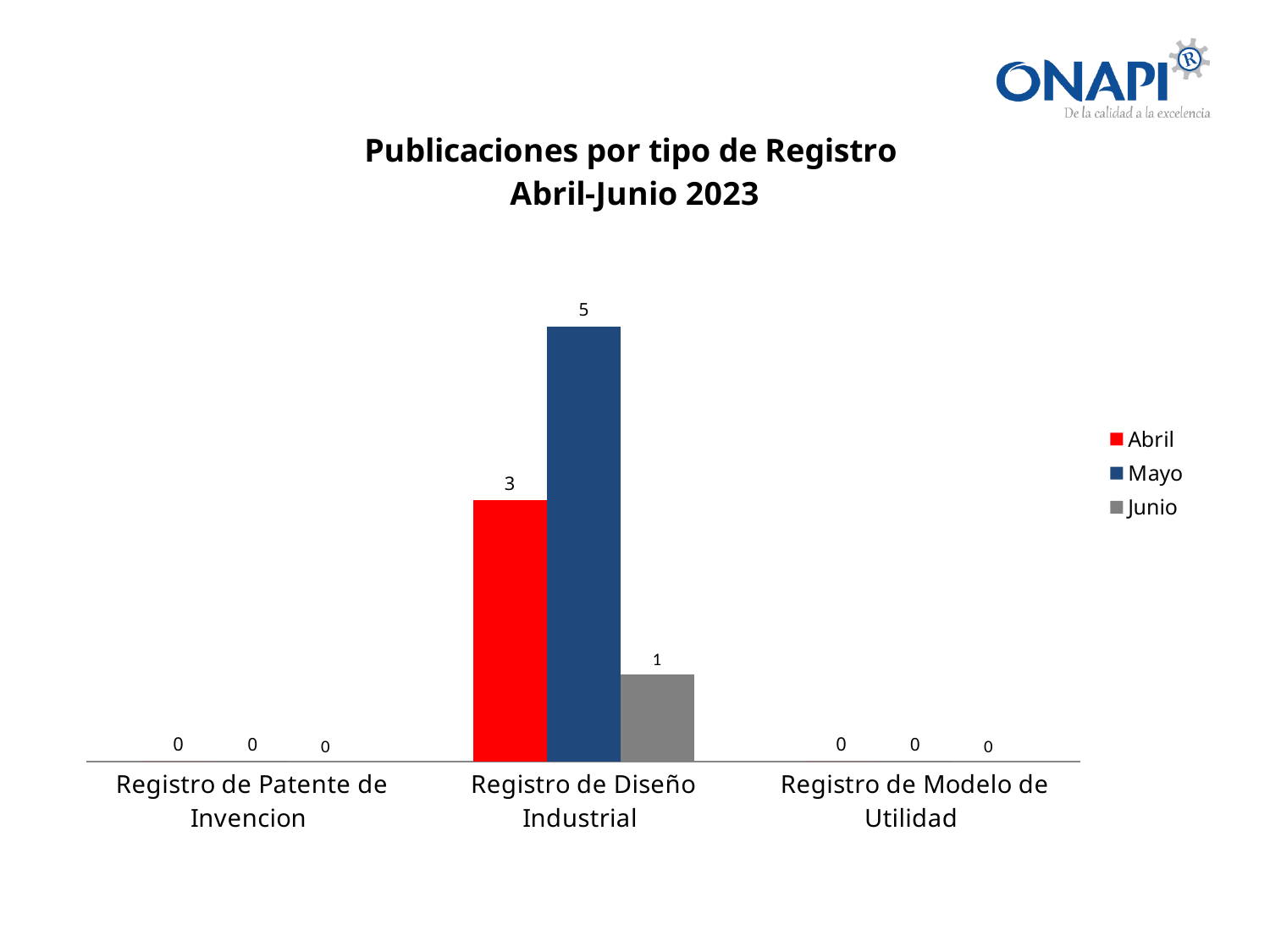
How many series does the legend list? 3 Which is larger for Registro de Diseño Industrial, the Abril value or the Junio value? Abril Which month has the highest value in the Registro de Diseño Industrial category? Mayo How many categories are shown on the x axis? 3 What is the value for Mayo in the Registro de Patente de Invencion category? 0 What is the difference between the Mayo and Abril values for Registro de Diseño Industrial? 2 What kind of chart is shown on the slide? Bar chart What is the value for Mayo in the Registro de Diseño Industrial category? 5 What is the value for Abril in the Registro de Diseño Industrial category? 3 Which month has the lowest value in the Registro de Diseño Industrial category? Junio What is the value for Junio in the Registro de Diseño Industrial category? 1 What is the title of the chart? Publicaciones por tipo de Registro Abril-Junio 2023